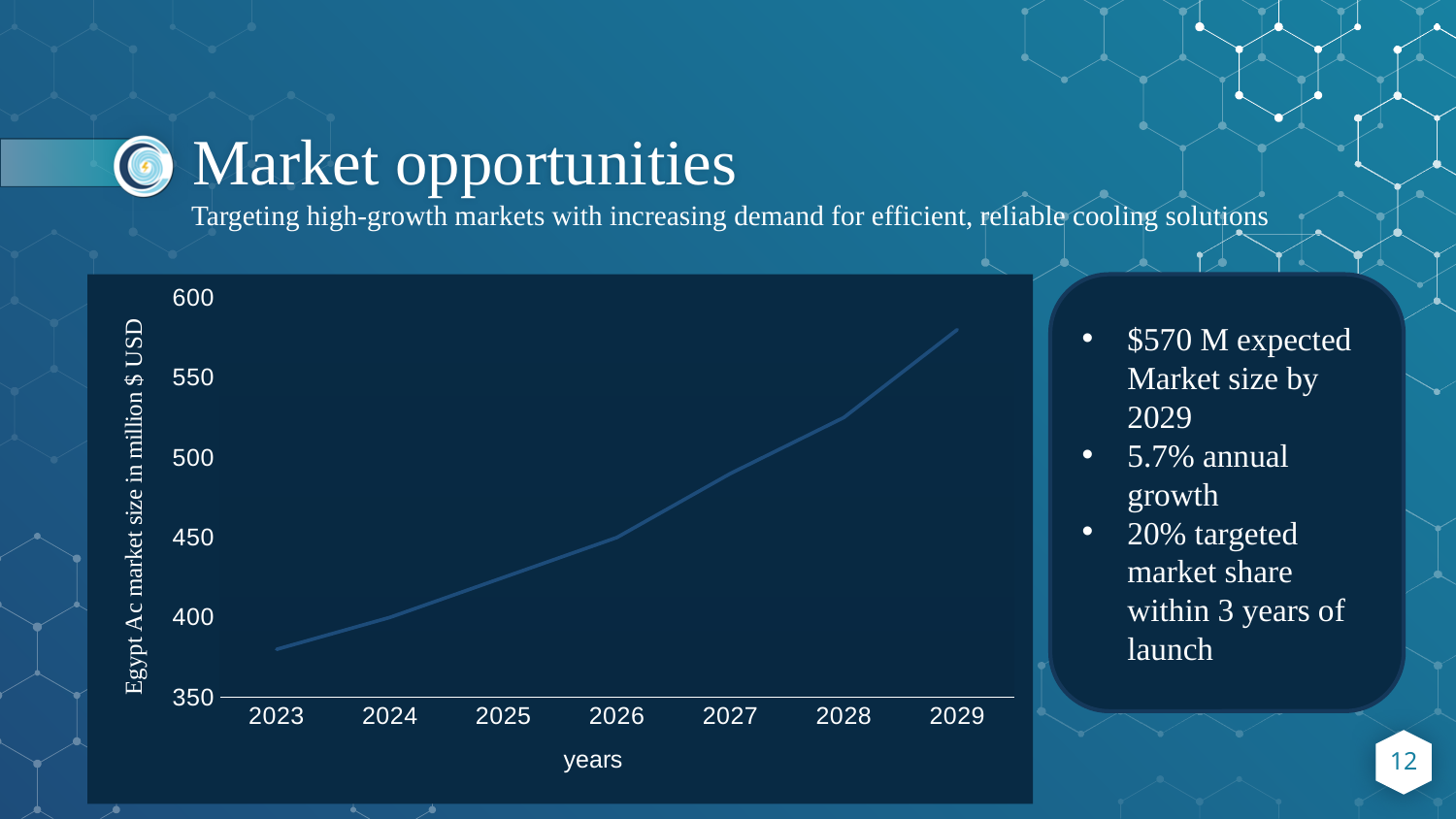
Do the values in the chart rise or fall from 2023 to 2029? rise Is the value for 2025 greater or less than 450? less Which year has the highest Egypt AC market size in the chart? 2029 What kind of chart is shown on the slide? line chart Is the value for 2028 greater or less than 500? greater How many years are plotted along the x axis of the chart? 7 Which year has the larger market size, 2025 or 2028? 2028 What is the title of the y axis of the chart? Egypt Ac market size in million $ USD Which year has the lowest Egypt AC market size in the chart? 2023 What is the title of the x axis of the chart? years Is the value for 2029 greater or less than 550? greater